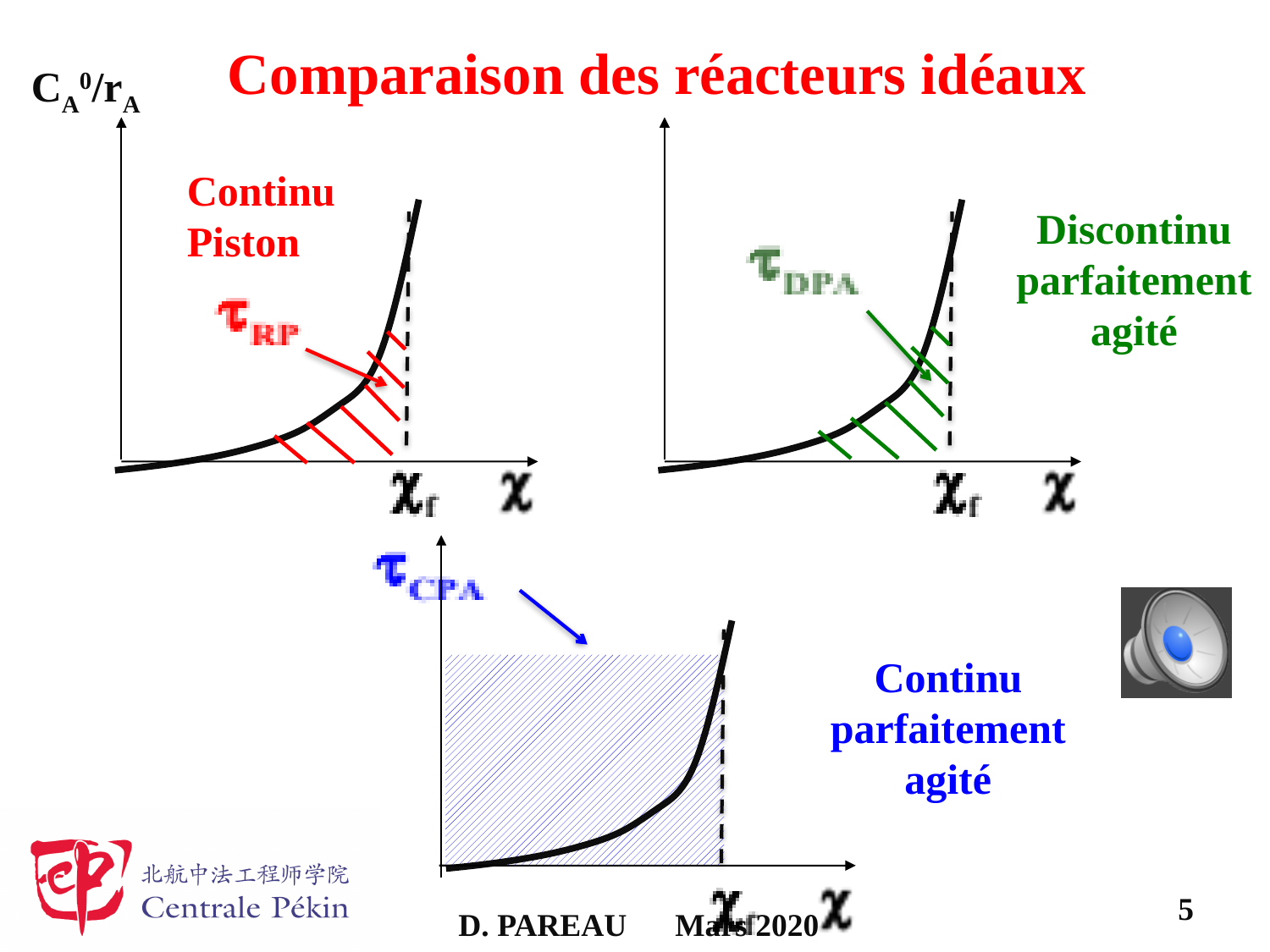
What kind of chart is the bottom 'Continu parfaitement agité' diagram? line chart In the bottom 'Continu parfaitement agité' chart, does the curve rise or fall as χ increases? rise What quantity is labelled on the vertical axis of the top-left chart? CA0/rA What kind of chart is the top-left 'Continu Piston' diagram? line chart What is the title of the slide containing the three charts? Comparaison des réacteurs idéaux In the top-right 'Discontinu parfaitement agité' chart, does the curve rise or fall along the x axis? rise In the top-left 'Continu Piston' chart, does the curve rise or fall as χ increases toward χf? rise